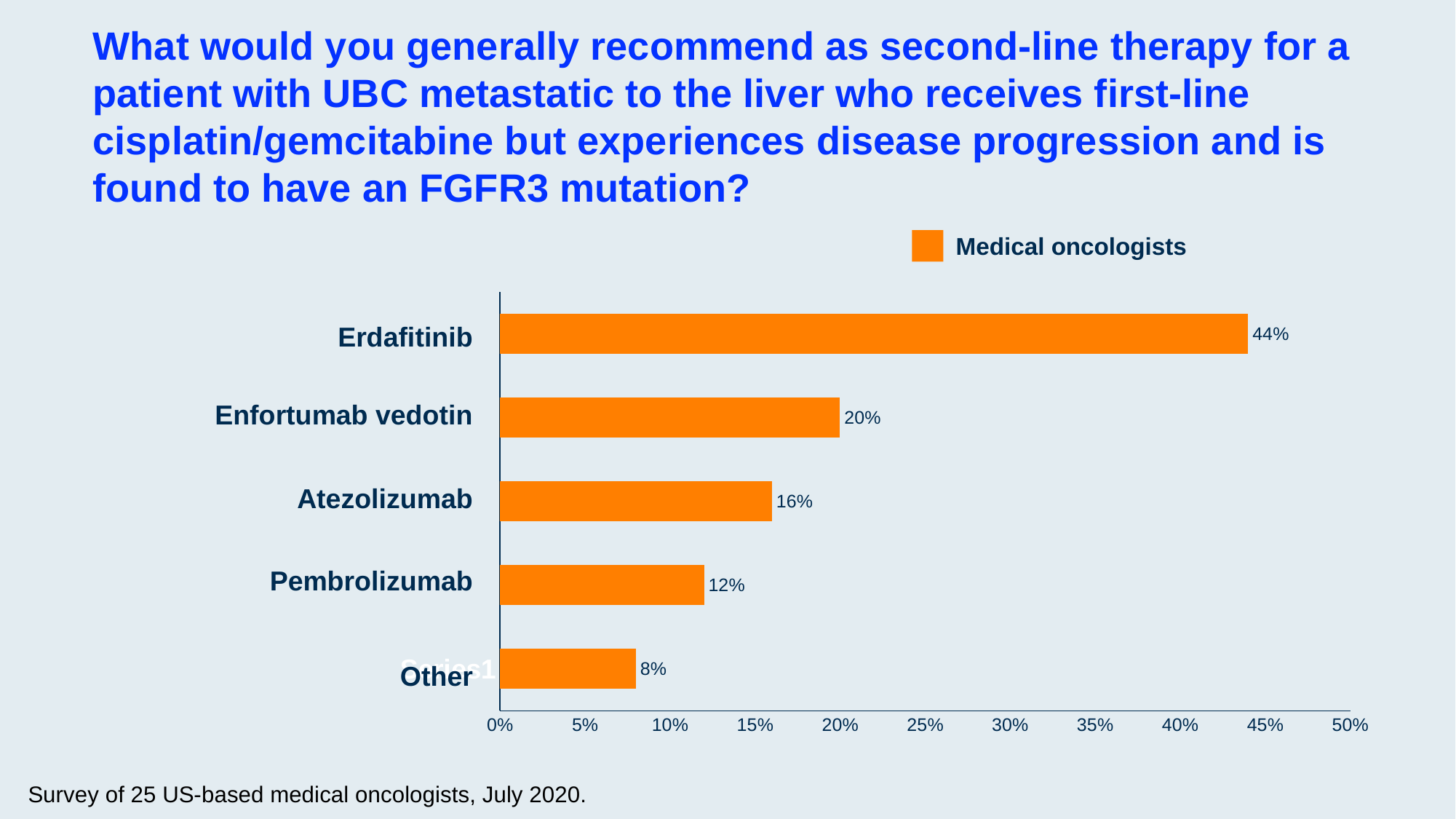
What percentage is shown for Atezolizumab? 16% How many categories are shown on the chart? 5 Which is larger, the value for Atezolizumab or the value for Pembrolizumab? Atezolizumab What series name is shown in the legend? Medical oncologists What is the value for Pembrolizumab? 12% What kind of chart is shown on the slide? Bar chart What is the difference between the values for Erdafitinib and Enfortumab vedotin? 24% Which therapy has the highest percentage? Erdafitinib How many series does the legend list? 1 What is the value for Enfortumab vedotin? 20% Which category has the lowest percentage? Other What percentage of medical oncologists recommended Erdafitinib? 44%